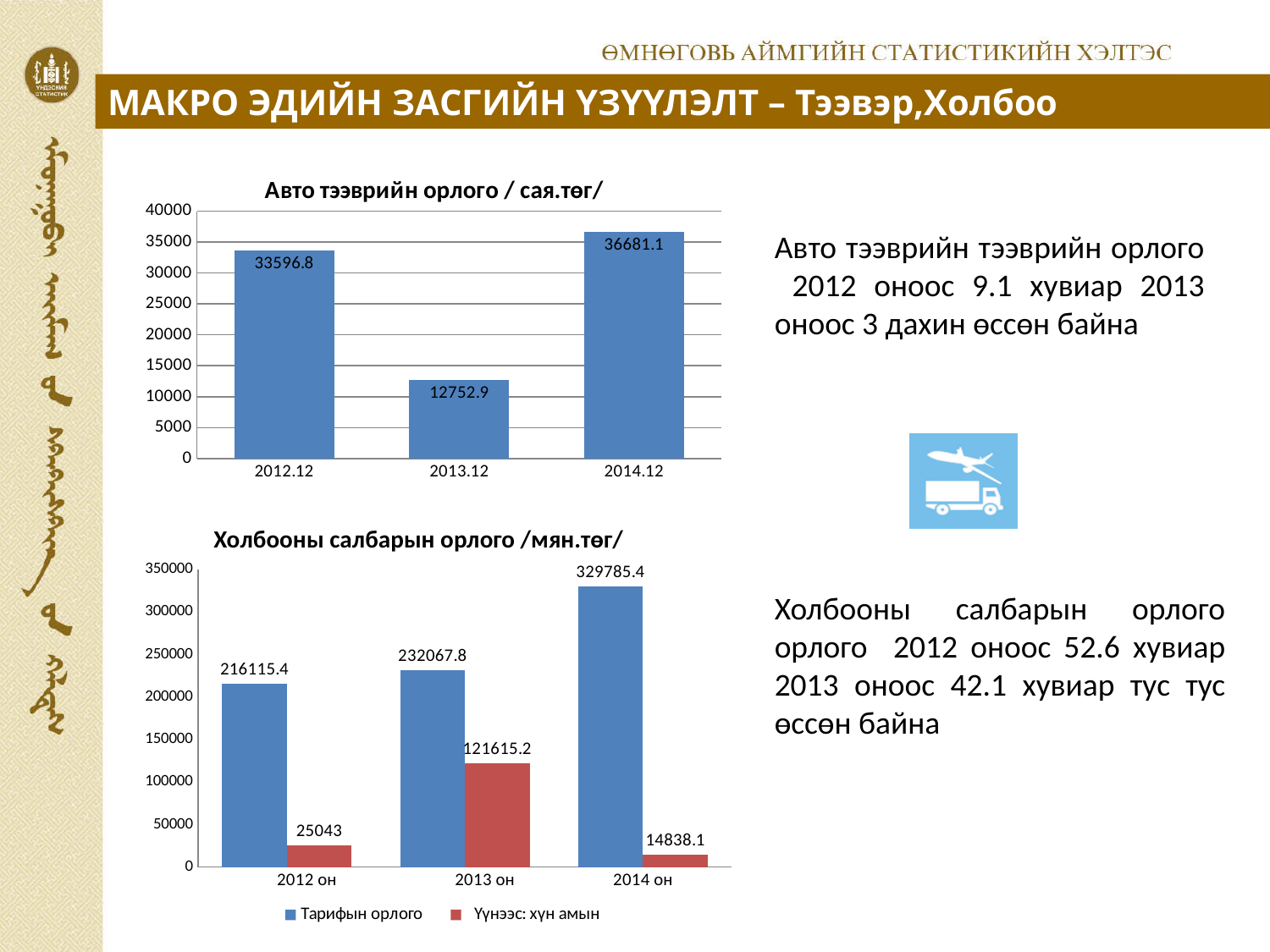
In the chart titled "Авто тээврийн орлого / сая.төг/", how many categories are shown on the x axis? 3 In the chart titled "Холбооны салбарын орлого /мян.төг/", how many series does the legend list? 2 In the chart titled "Авто тээврийн орлого / сая.төг/", which category has the lowest value? 2013.12 What kind of chart is the top chart on the slide? bar chart In the chart titled "Авто тээврийн орлого / сая.төг/", which category has the highest value? 2014.12 In the chart titled "Холбооны салбарын орлого /мян.төг/", which is larger: Тарифын орлого for 2013 он or Тарифын орлого for 2012 он? Тарифын орлого for 2013 он In the chart titled "Холбооны салбарын орлого /мян.төг/", what is the value of Тарифын орлого for 2014 он? 329785.4 In the chart titled "Авто тээврийн орлого / сая.төг/", what is the value for 2013.12? 12752.9 In the chart titled "Холбооны салбарын орлого /мян.төг/", what is the value of Үүнээс: хүн амын for 2012 он? 25043 In the chart titled "Холбооны салбарын орлого /мян.төг/", does Тарифын орлого rise or fall from 2012 он to 2014 он? rise In the chart titled "Авто тээврийн орлого / сая.төг/", what is the difference between the values for 2014.12 and 2012.12? 3084.3 In the chart titled "Холбооны салбарын орлого /мян.төг/", in which year is Үүнээс: хүн амын highest? 2013 он